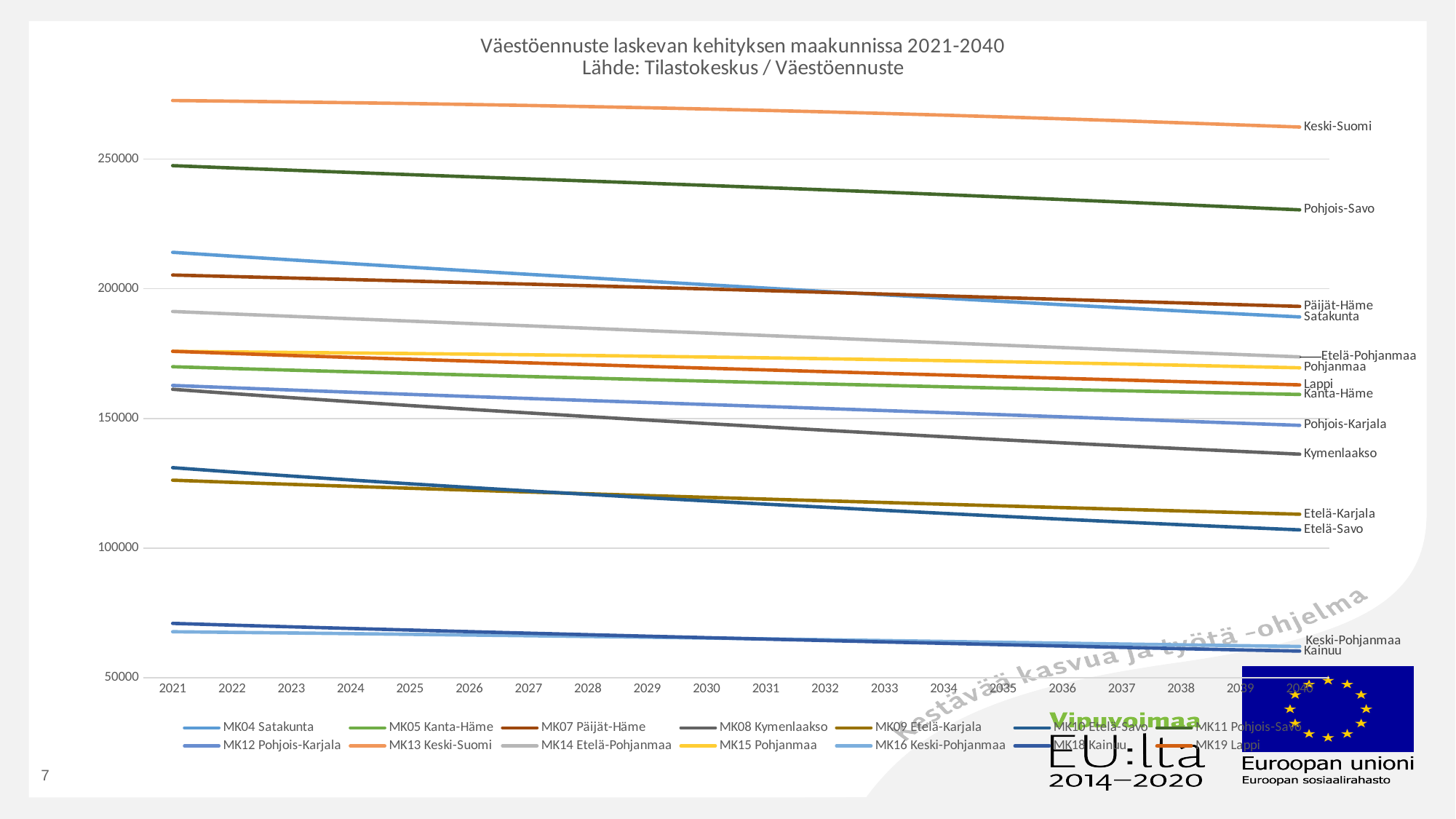
Is the value for Kymenlaakso in 2040 greater or less than 150000? less What is the first line of the chart title? Väestöennuste laskevan kehityksen maakunnissa 2021-2040 Does the Keski-Suomi line rise or fall from 2021 to 2040? fall How many series does the legend list? 14 Which region has the lowest population forecast in 2040? Kainuu Is the value for Keski-Suomi in 2021 greater or less than 250000? greater Which region has the highest population forecast throughout 2021-2040? Keski-Suomi In 2021, which is larger: the value for Satakunta or the value for Päijät-Häme? Satakunta Is the value for Etelä-Savo in 2021 greater or less than 100000? greater How many years are plotted along the x axis? 20 What kind of chart is shown on the slide? line chart